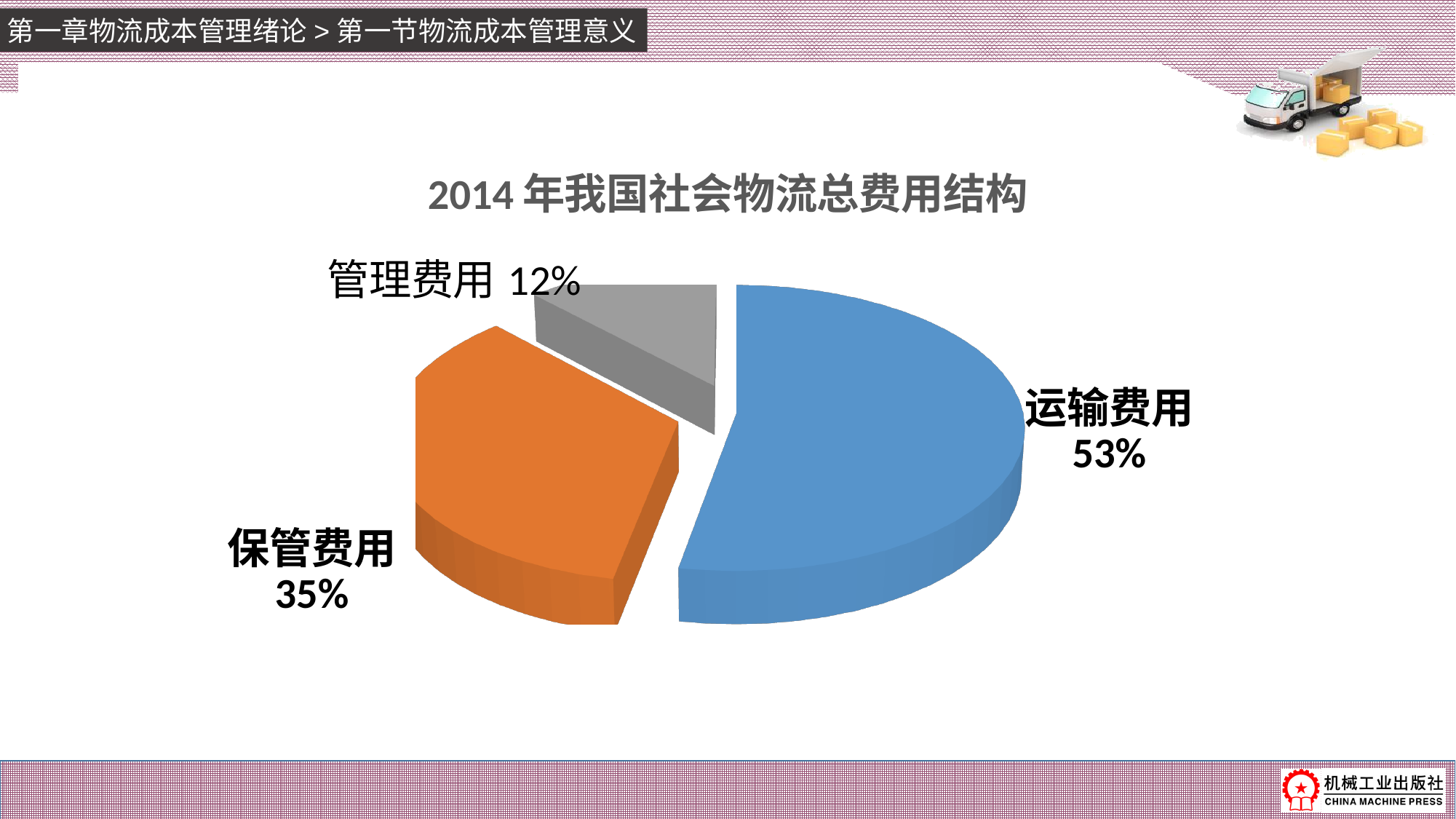
Which category has the smallest share of the pie? 管理费用 How many slices does the pie chart have? 3 Which category has the largest share of the pie? 运输费用 Which is larger, the share for 保管费用 or the share for 管理费用? 保管费用 What colour is the slice for 运输费用? Blue What share of the pie does 运输费用 account for? 53% What is the title of the chart? 2014 年我国社会物流总费用结构 What share of the pie does 保管费用 account for? 35% What is the difference in percentage points between 运输费用 and 保管费用? 18 What is the difference in percentage points between 保管费用 and 管理费用? 23 What share of the pie does 管理费用 account for? 12% What type of chart is shown on the slide? Pie chart